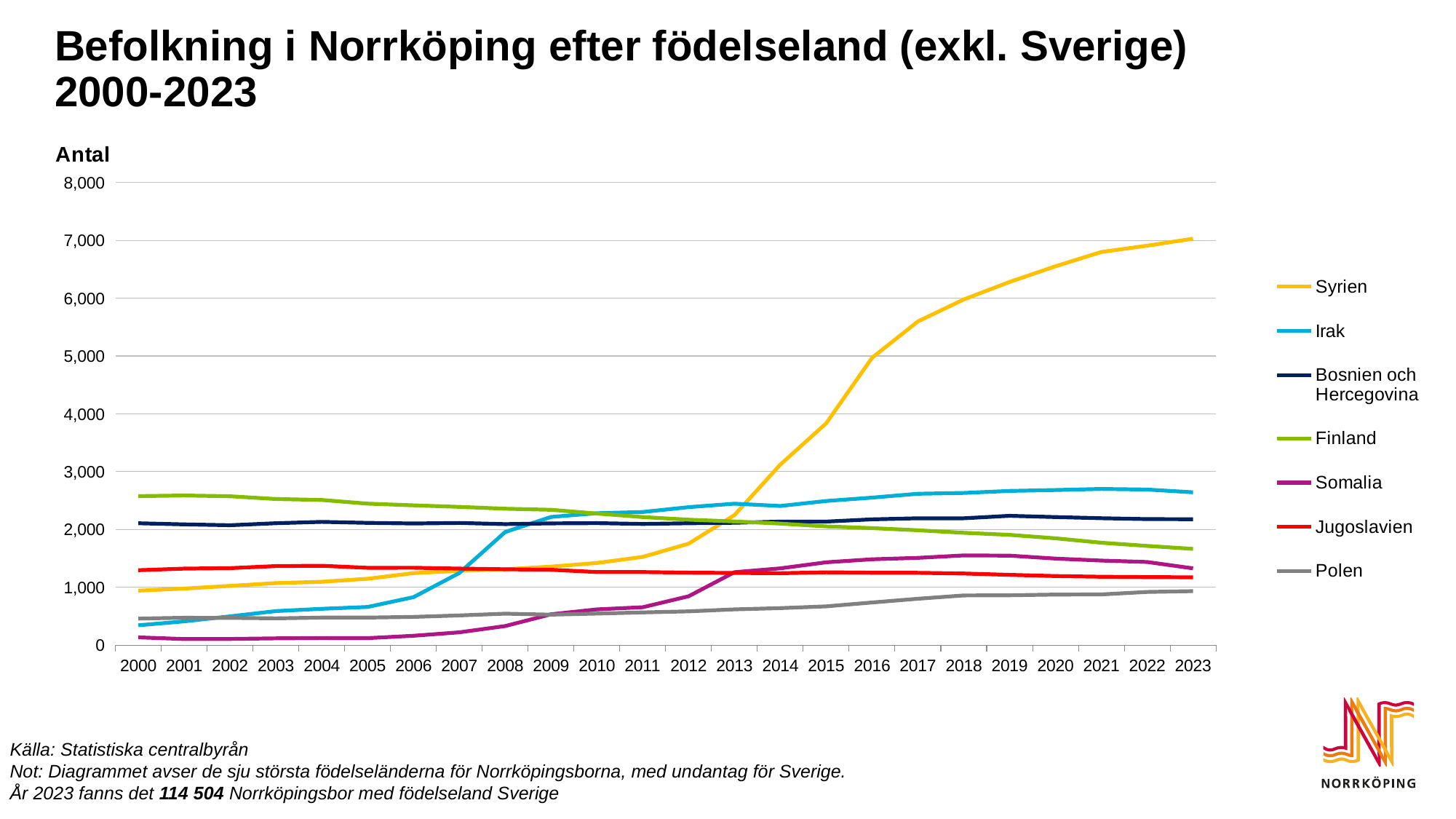
Is the value for Somalia in 2023 greater or less than 2,000? less How many series does the legend list? 7 Which birth country has the lowest value in 2000? Somalia What kind of chart is shown on the slide? line chart Does the line for Finland rise or fall from 2000 to 2023? fall Is the value for Syrien in 2023 greater or less than 6,000? greater Which birth country has the lowest value in 2023? Polen Which birth country has the highest value in 2023? Syrien How many years are shown along the x axis? 24 Which birth country has the highest value in 2000? Finland In 2023, which is larger: the value for Irak or the value for Bosnien och Hercegovina? Irak What is the title of the chart? Befolkning i Norrköping efter födelseland (exkl. Sverige) 2000-2023